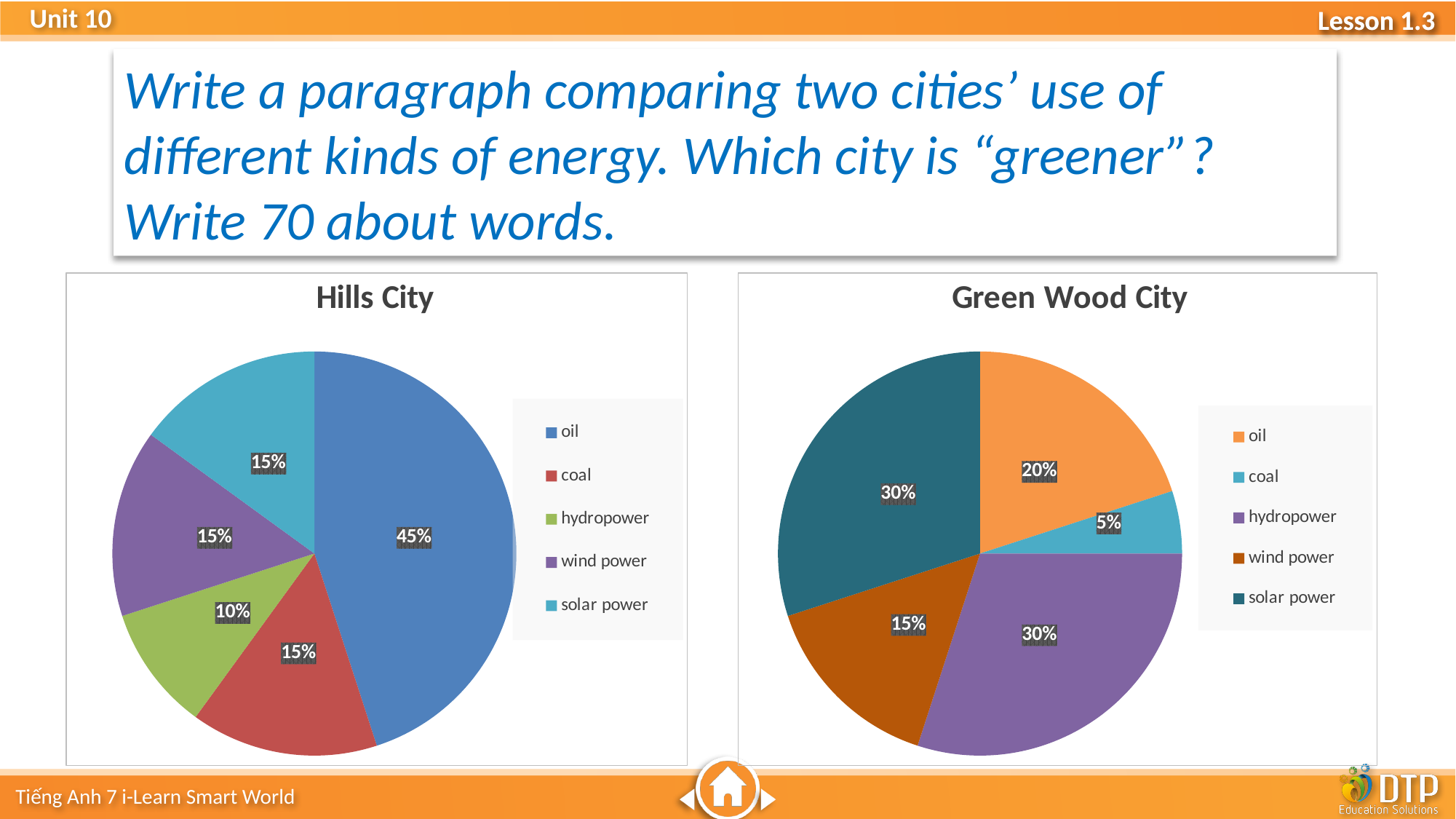
In the Green Wood City chart, what percentage is hydropower? 30% In the Hills City chart, which energy source has the largest share? oil In the Green Wood City chart, what percentage is coal? 5% In the Green Wood City chart, what is the difference between the solar power share and the oil share? 10% In the Green Wood City chart, which energy source has the smallest share? coal In the Hills City chart, which energy source has the smallest share? hydropower How many energy sources are shown in the Hills City chart? 5 What type of chart is the Green Wood City chart? pie chart Which city has the larger share of solar power, Hills City or Green Wood City? Green Wood City In the Hills City chart, what percentage is oil? 45% In the Hills City chart, what colour is the oil slice? blue In the Hills City chart, what is the difference between the oil share and the coal share? 30%